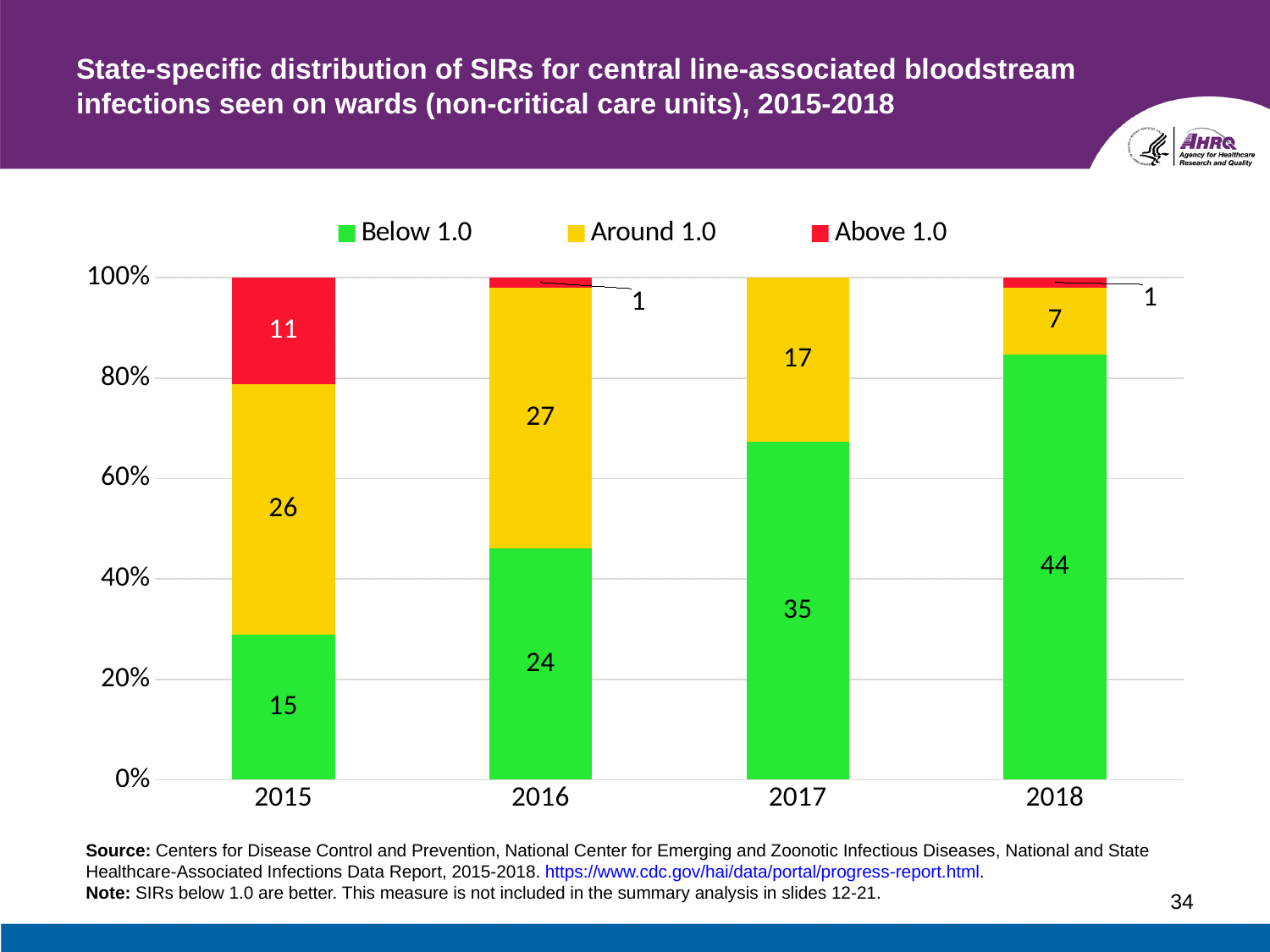
How many years are shown on the x axis? 4 What is the number of states with SIRs around 1.0 in 2016? 27 What is the difference between the number of states with SIRs below 1.0 in 2018 and in 2015? 29 In which year is the number of states with SIRs below 1.0 the highest? 2018 Which is larger in 2016: the number of states with SIRs below 1.0 or around 1.0? Around 1.0 What kind of chart is shown on the slide? Stacked bar chart What is the number of states with SIRs below 1.0 in 2015? 15 In which year is the number of states with SIRs around 1.0 the lowest? 2018 What is the number of states with SIRs around 1.0 in 2018? 7 Does the number of states with SIRs below 1.0 rise or fall from 2015 to 2018? Rise What is the number of states with SIRs above 1.0 in 2015? 11 How many series does the legend list? 3